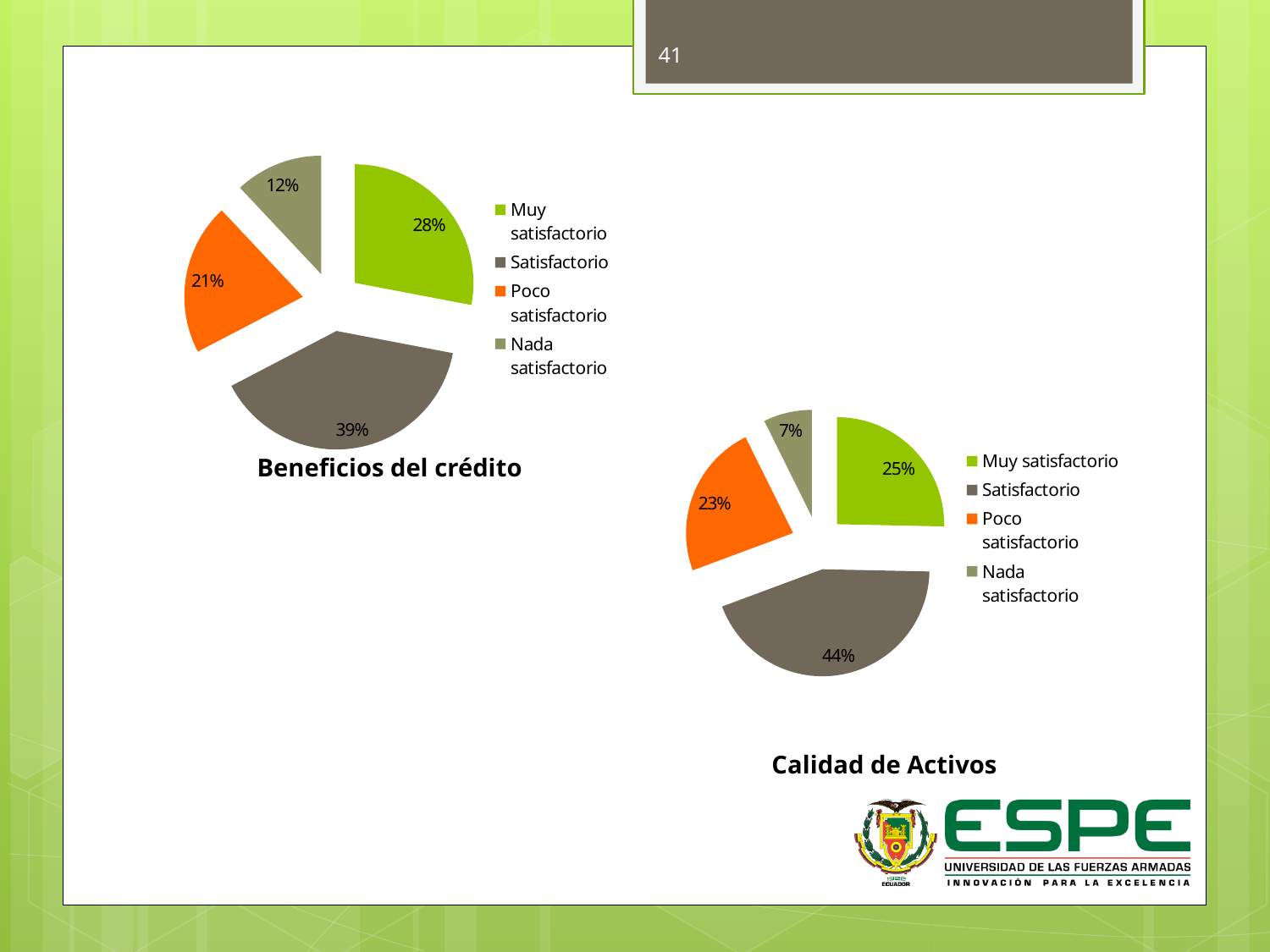
In the 'Calidad de Activos' chart, what share is labelled for Muy satisfactorio? 25% In the 'Beneficios del crédito' chart, what share is labelled for Satisfactorio? 39% In the 'Beneficios del crédito' chart, what is the difference between the Muy satisfactorio and Poco satisfactorio shares? 7% In the 'Beneficios del crédito' chart, which category has the smallest slice? Nada satisfactorio What type of chart is 'Beneficios del crédito'? Pie chart In the 'Beneficios del crédito' chart, which category has the largest slice? Satisfactorio In the 'Calidad de Activos' chart, which category has the largest slice? Satisfactorio In the 'Calidad de Activos' chart, what share is labelled for Poco satisfactorio? 23% How many categories does the legend of the 'Calidad de Activos' chart list? 4 In the 'Calidad de Activos' chart, which category has the smallest slice? Nada satisfactorio In the 'Calidad de Activos' chart, which is larger: Muy satisfactorio or Poco satisfactorio? Muy satisfactorio In the 'Beneficios del crédito' chart, what share is labelled for Nada satisfactorio? 12%